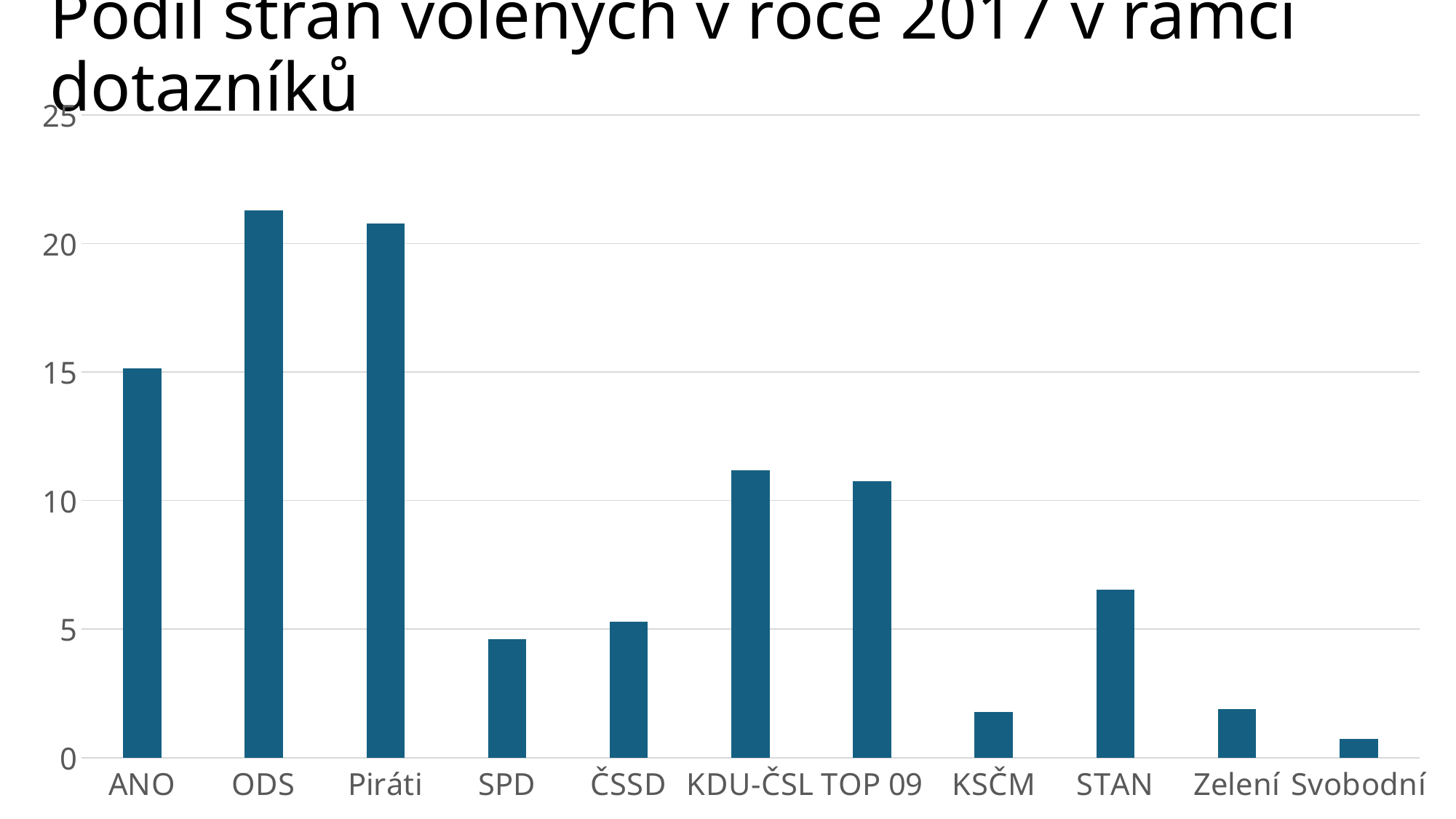
Which party has the lowest bar? Svobodní Which has the larger value, ANO or KDU-ČSL? ANO What kind of chart is shown on the slide? bar chart Which has the larger value, STAN or ČSSD? STAN Is the value for STAN greater or less than 5? greater What is the title of the chart? Podíl stran volených v roce 2017 v rámci dotazníků How many parties (categories) are shown on the x axis? 11 Is the value for ODS greater or less than 20? greater Is the value for SPD greater or less than 5? less Which party has the highest bar? ODS